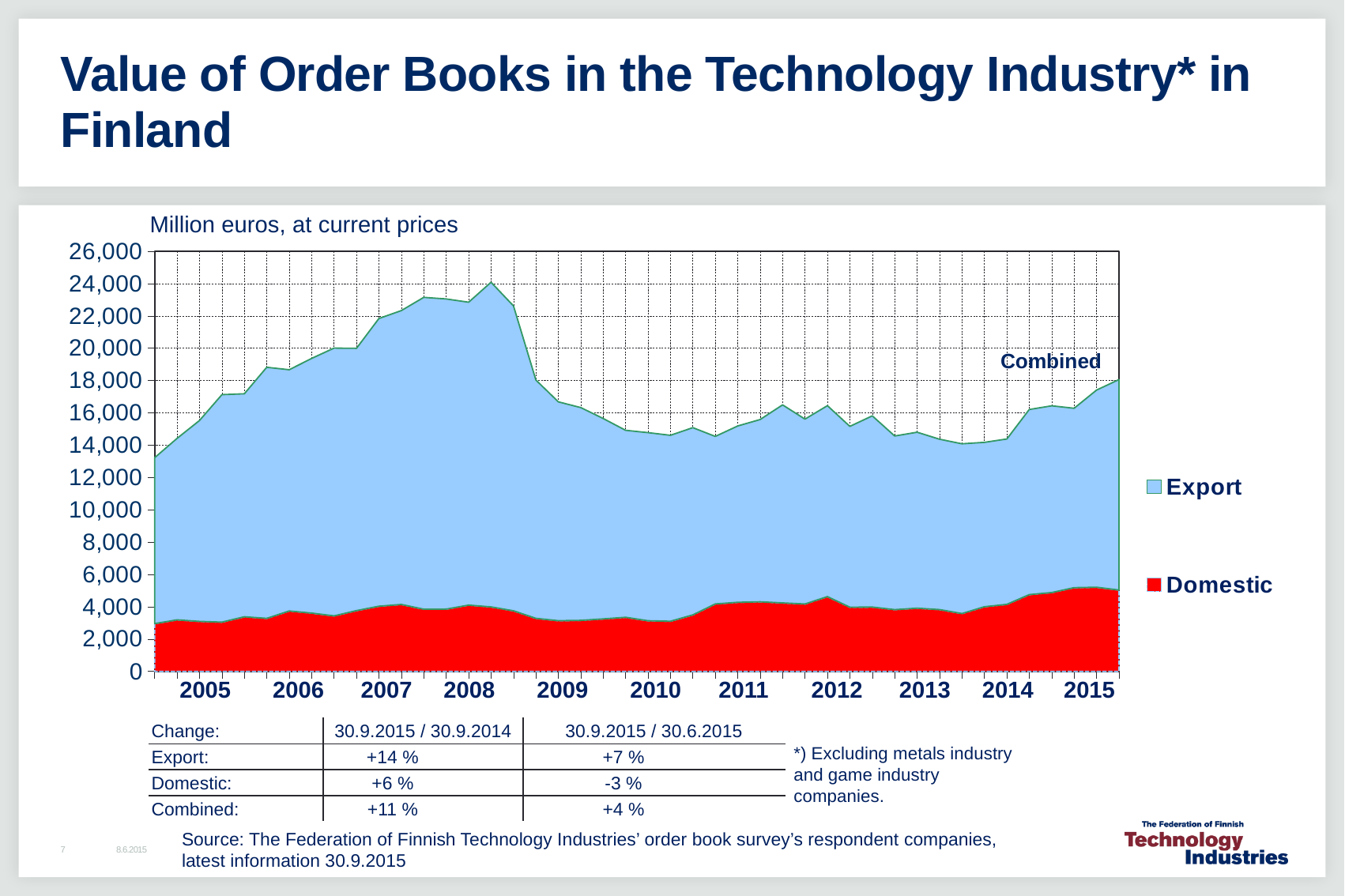
Is the Domestic value at the end of 2015 greater or less than 4,000? greater Does the combined value rise or fall between its 2008 peak and 2009? fall What kind of chart is shown on the slide? area chart In which year does the combined value of order books reach its highest point? 2008 Does the combined value rise or fall from 2005 to 2008? rise Is the Domestic value at the start of 2005 greater or less than 4,000? less How many series does the chart's legend list? 2 What unit is stated above the chart's y axis? Million euros, at current prices What are the two series named in the chart's legend? Export and Domestic According to the table below the chart, what is the Export change for 30.9.2015 / 30.9.2014? +14 % Is the peak combined value in 2008 greater or less than 22,000? greater